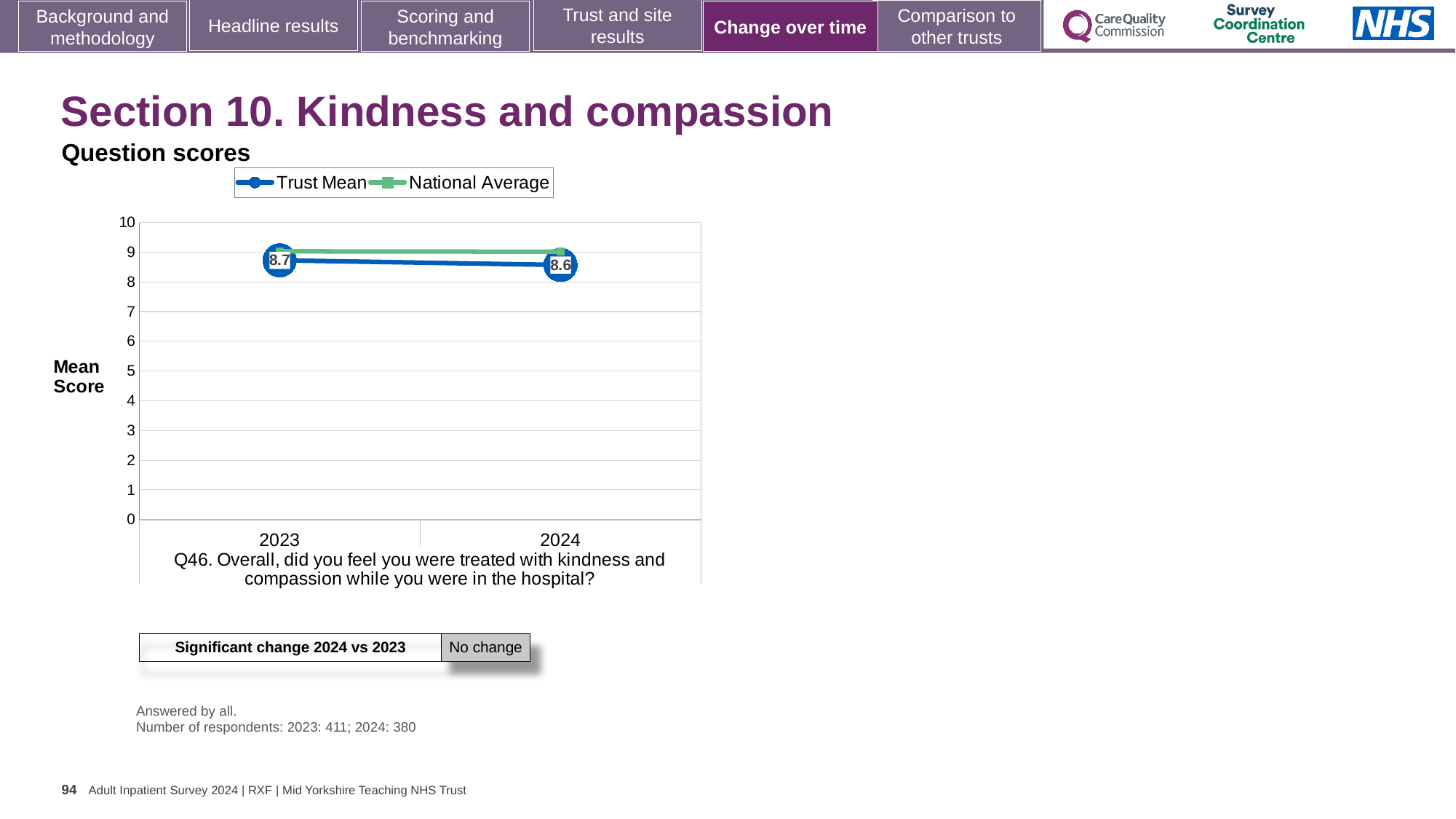
What kind of chart is shown on the slide? line chart Does the Trust Mean rise or fall from 2023 to 2024? fall How many years are shown on the x axis of the chart? 2 By how much did the Trust Mean change from 2023 to 2024? 0.1 What is the Trust Mean score for 2024? 8.6 Which year has the higher Trust Mean score, 2023 or 2024? 2023 Is the National Average value for 2023 greater or less than 8? greater What are the two series named in the chart legend? Trust Mean and National Average What is the Trust Mean score for 2023? 8.7 Is the National Average value for 2024 greater or less than 7? greater What is the label on the y axis of the chart? Mean Score How many series does the chart legend list? 2